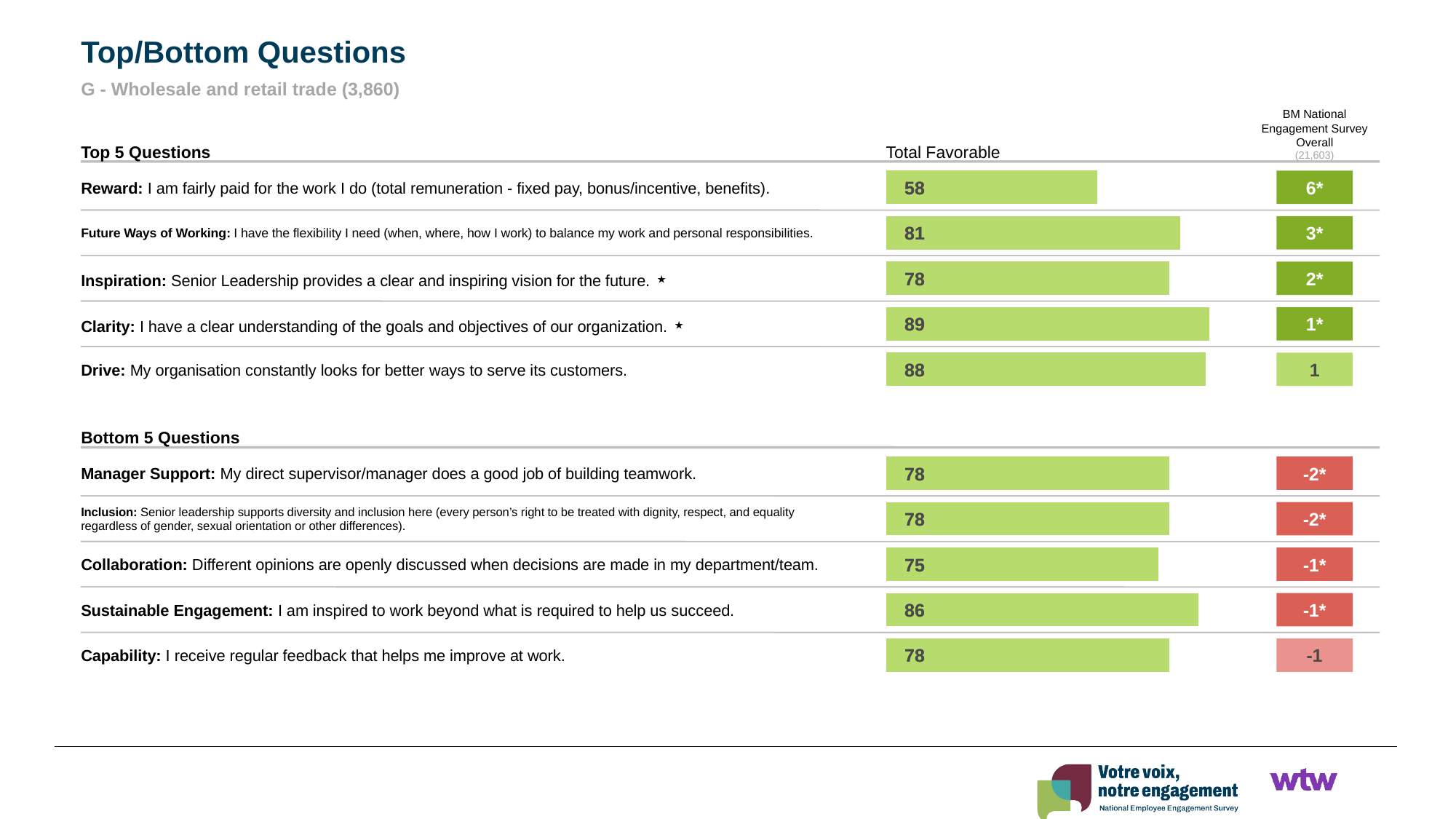
In the Bottom 5 Questions chart, which question has the highest Total Favorable value? Sustainable Engagement What kind of chart is used to show the Total Favorable values on this slide? Bar chart In the Bottom 5 Questions chart, what is the BM National Engagement Survey Overall difference shown for Manager Support? -2* In the Bottom 5 Questions chart, what is the Total Favorable value for Sustainable Engagement? 86 In the Top 5 Questions chart, which question has the lowest Total Favorable value? Reward In the Top 5 Questions chart, what is the BM National Engagement Survey Overall difference shown for Reward? 6* In the Top 5 Questions chart, what is the difference in Total Favorable between Clarity and Reward? 31 In the Bottom 5 Questions chart, which question has the lowest Total Favorable value? Collaboration In the Top 5 Questions chart, what is the Total Favorable value for Reward? 58 In the Top 5 Questions chart, what is the Total Favorable value for Clarity? 89 In the Top 5 Questions chart, which question has the highest Total Favorable value? Clarity How many questions are listed in the Bottom 5 Questions chart? 5